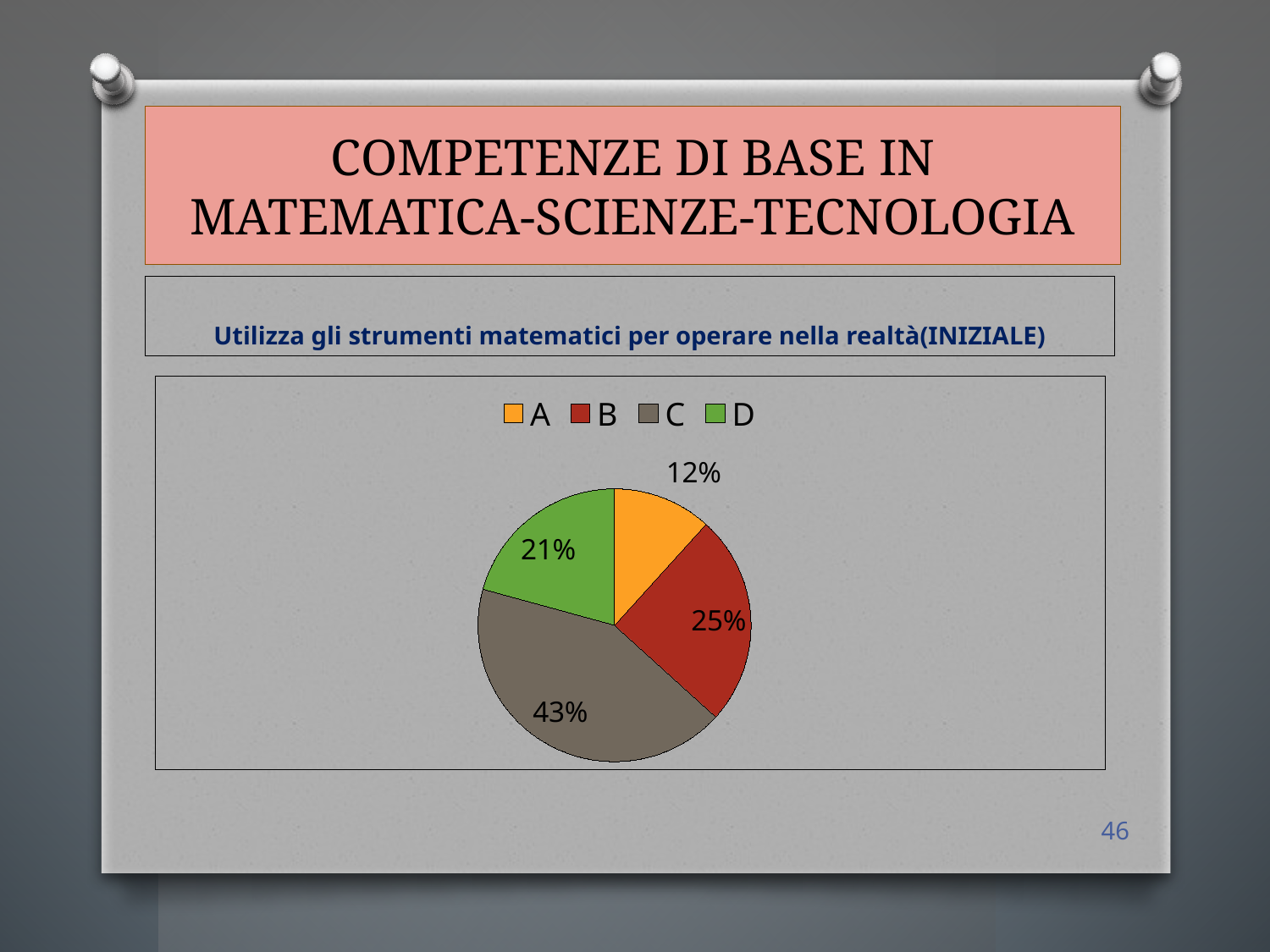
How many entries does the legend list? 4 What is the difference between the values for C and B? 18% How many categories does the pie chart show? 4 Which is larger, the value for B or the value for D? B What colour is the slice for category C? grey What is the value for category B? 25% What is the value for category C? 43% Which category has the largest share of the pie? C What is the value for category D? 21% What kind of chart is shown on the slide? pie chart Which category has the smallest share of the pie? A What is the value for category A? 12%